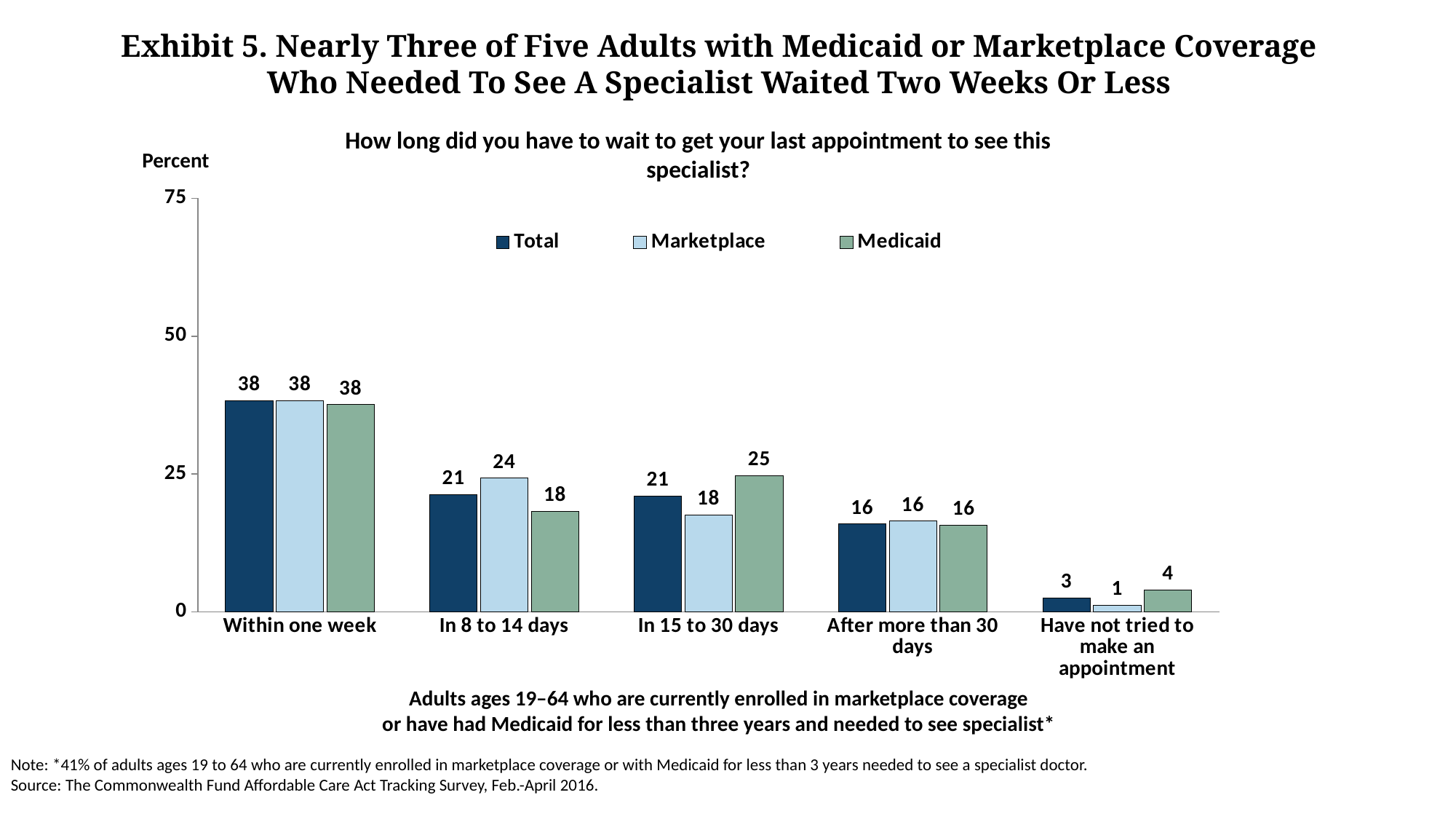
Which category has the highest Total value? Within one week What is the Medicaid value for "In 15 to 30 days"? 25 What is the Marketplace value for "In 8 to 14 days"? 24 How many categories are shown on the x axis? 5 What is the difference between the Medicaid and Marketplace values for "In 15 to 30 days"? 7 Which category has the lowest Marketplace value? Have not tried to make an appointment What is the Total value for "Have not tried to make an appointment"? 3 For "In 8 to 14 days", which is larger: the Marketplace value or the Medicaid value? Marketplace What kind of chart is shown on the slide? Bar chart What is the label on the y axis? Percent How many series does the legend list? 3 Is the Total value for "Within one week" greater or less than 25? greater